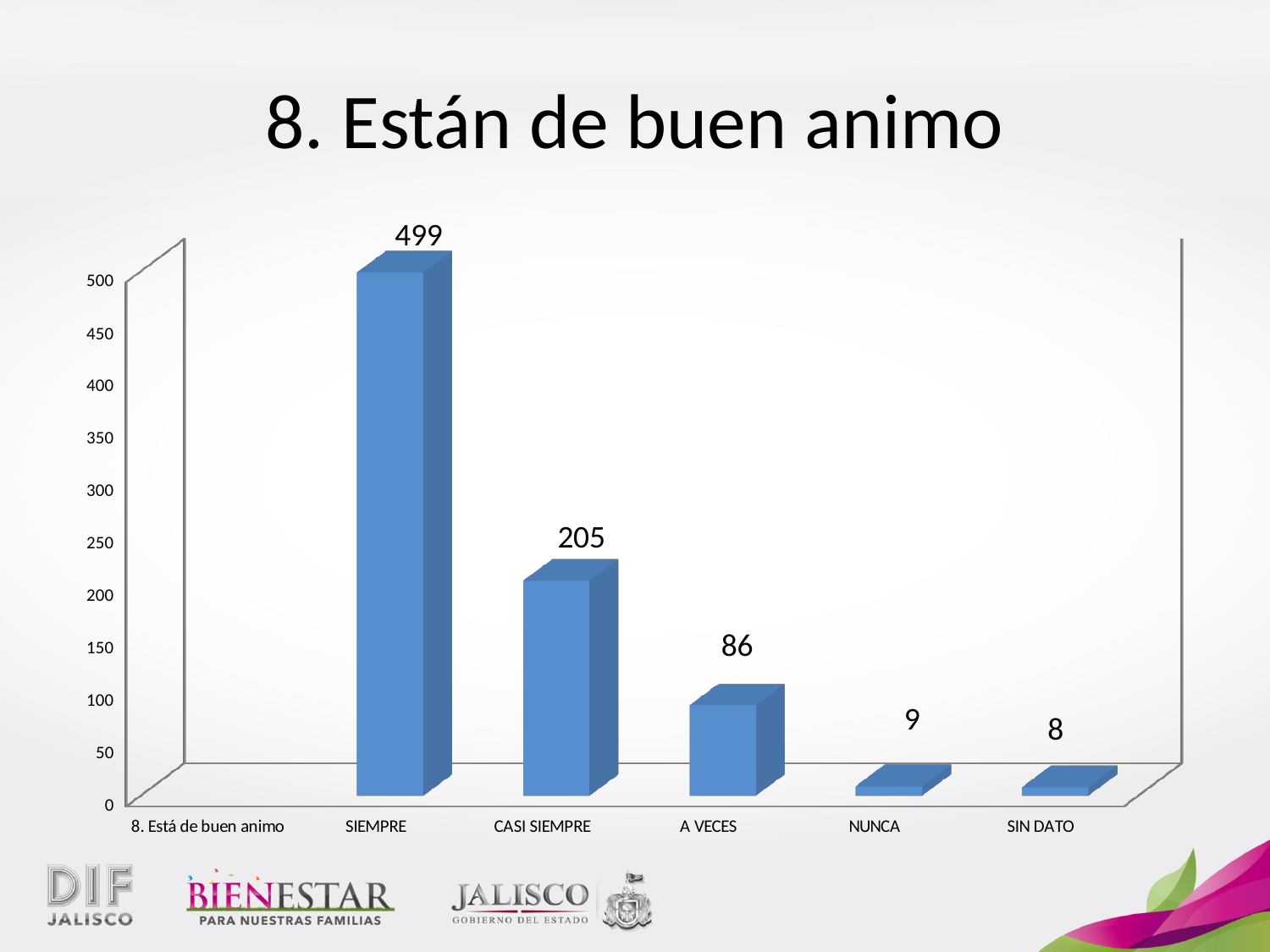
What is the title of the slide? 8. Están de buen animo Which category has the highest value? SIEMPRE What is the difference between the values for SIEMPRE and CASI SIEMPRE? 294 What kind of chart is shown on the slide? Bar chart Which category has the lowest value? SIN DATO What is the value for SIN DATO? 8 Which is larger, the value for CASI SIEMPRE or the value for A VECES? CASI SIEMPRE What is the value for SIEMPRE? 499 What is the value for A VECES? 86 What is the value for NUNCA? 9 How many bars are plotted in the chart? 5 What is the value for CASI SIEMPRE? 205